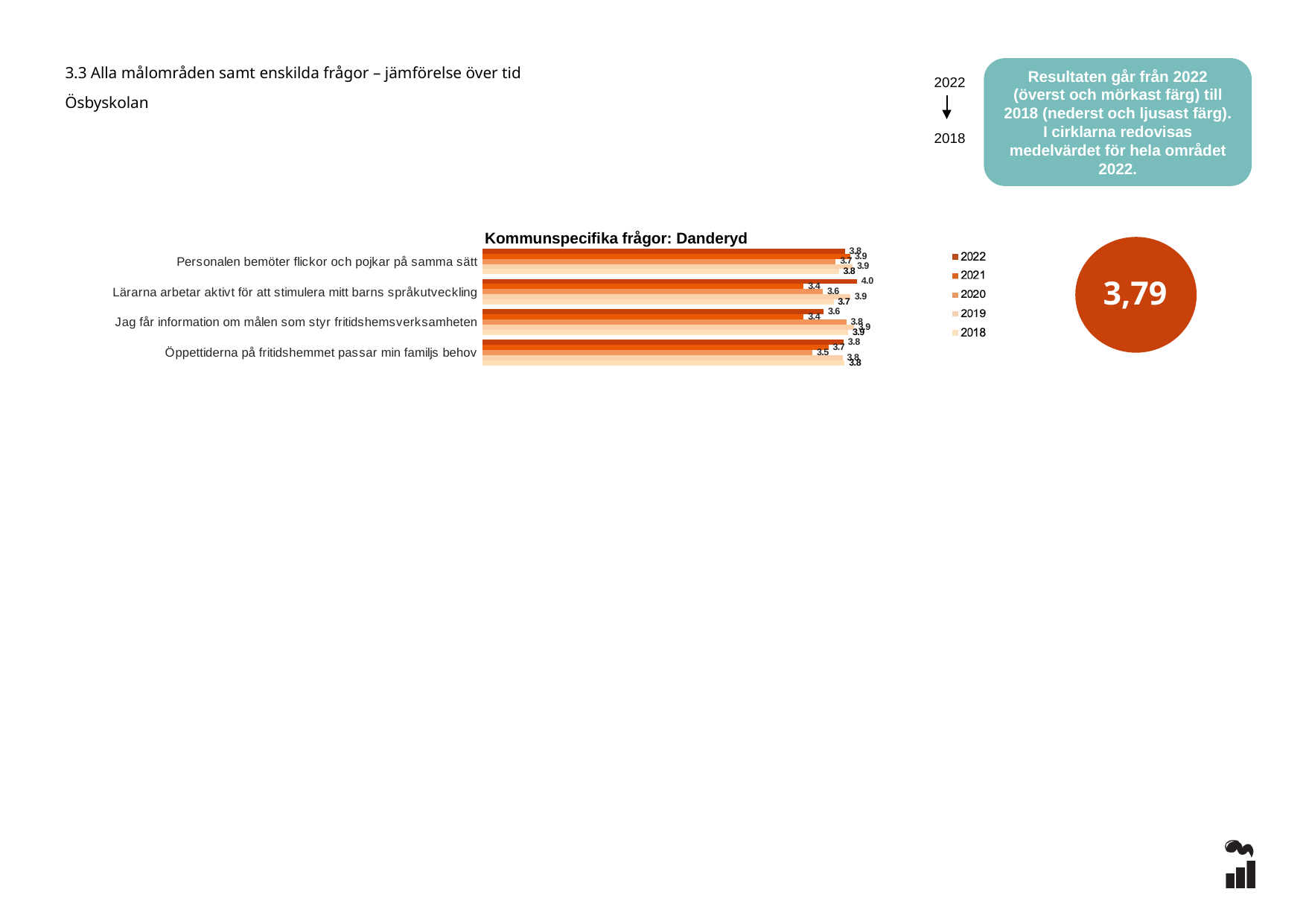
For 'Lärarna arbetar aktivt för att stimulera mitt barns språkutveckling', which year has the larger value, 2022 or 2021? 2022 What kind of chart is shown on the slide? bar chart What is the 2021 value for 'Jag får information om målen som styr fritidshemsverksamheten'? 3.4 What mean value for the whole area in 2022 is shown in the circle next to the chart? 3,79 What is the 2020 value for 'Öppettiderna på fritidshemmet passar min familjs behov'? 3.5 For 'Lärarna arbetar aktivt för att stimulera mitt barns språkutveckling', what is the difference between the 2022 and 2021 values? 0.6 What is the 2022 value for 'Lärarna arbetar aktivt för att stimulera mitt barns språkutveckling'? 4.0 What is the title of the chart? Kommunspecifika frågor: Danderyd Which category has the highest 2022 value? Lärarna arbetar aktivt för att stimulera mitt barns språkutveckling How many categories (questions) are shown in the chart? 4 What is the 2021 value for 'Lärarna arbetar aktivt för att stimulera mitt barns språkutveckling'? 3.4 How many series does the chart legend list? 5